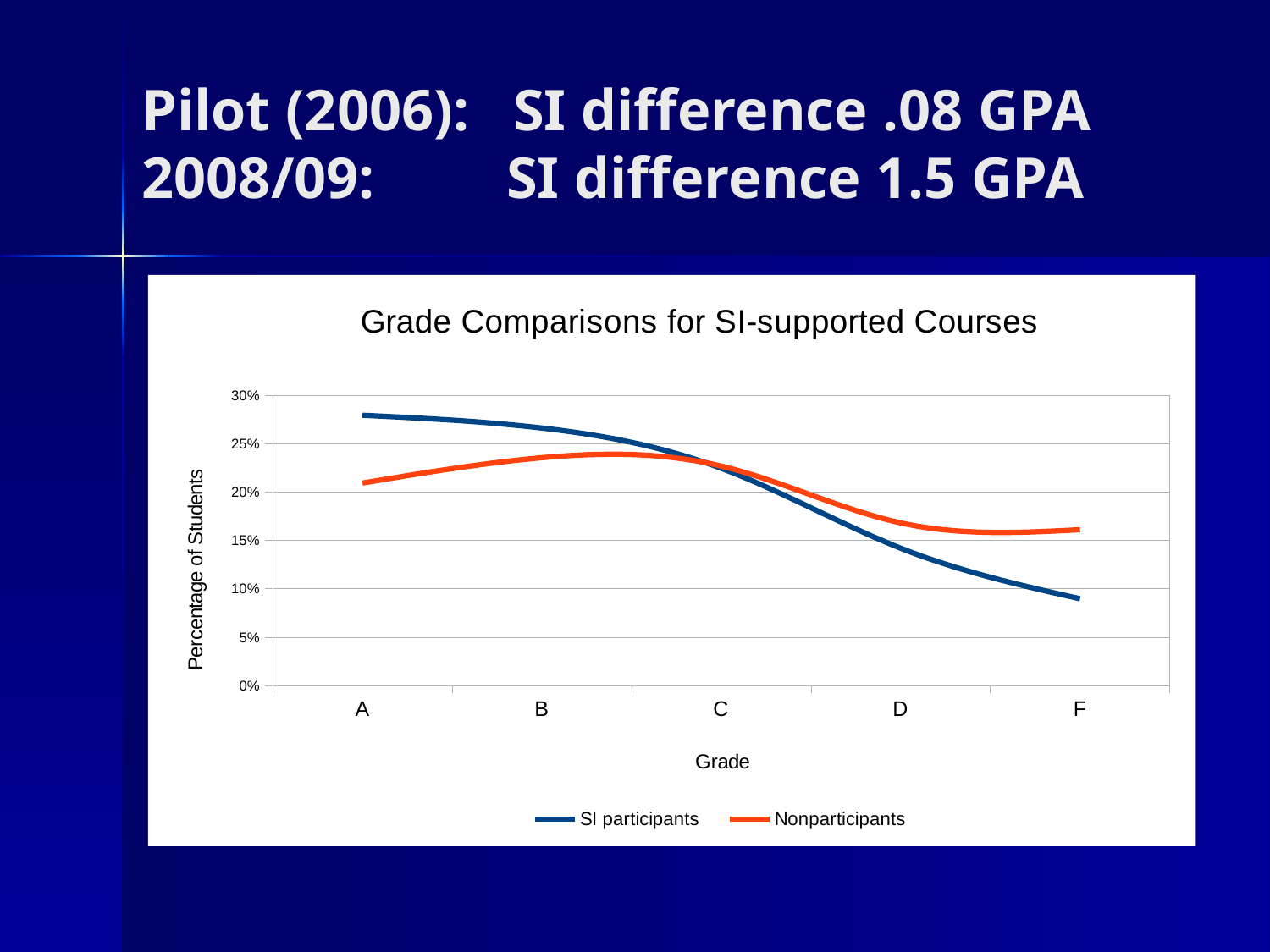
Is the value for SI participants at grade A greater or less than 25%? greater What kind of chart is shown on the slide? line chart Is the value for Nonparticipants at grade A greater or less than 25%? less Is the value for SI participants at grade F greater or less than 15%? less How many grade categories are shown on the x axis? 5 For SI participants, do the values rise or fall from grade A to grade F? fall At grade F, which series has the higher value, SI participants or Nonparticipants? Nonparticipants What is the title of the chart? Grade Comparisons for SI-supported Courses How many series does the legend list? 2 What is the label of the y axis? Percentage of Students At grade A, which series has the higher value, SI participants or Nonparticipants? SI participants